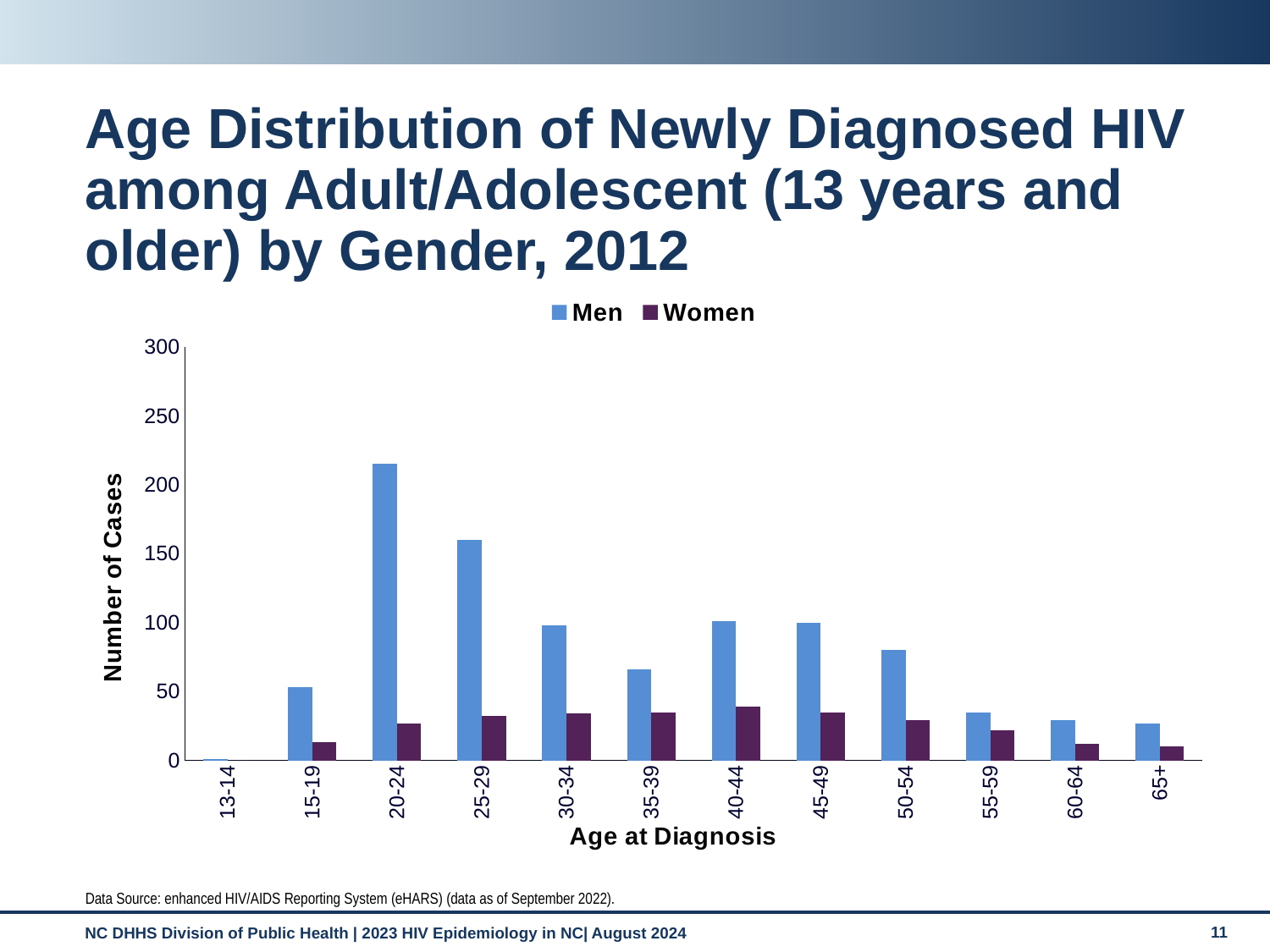
Is the value for Men in the 20-24 age group greater or less than 200? greater Is the value for Women in the 40-44 age group greater or less than 50? less Which age group has the lowest number of cases for Men? 13-14 Which age group has the highest number of cases for Men? 20-24 Is the value for Men in the 35-39 age group greater or less than 100? less Which is larger for Men: the 30-34 age group or the 35-39 age group? 30-34 Do the values for Men rise or fall from the 45-49 age group to the 65+ age group? fall How many age groups are shown on the x axis? 12 What kind of chart is shown on the slide? bar chart How many series does the legend list? 2 What is the label of the y axis? Number of Cases